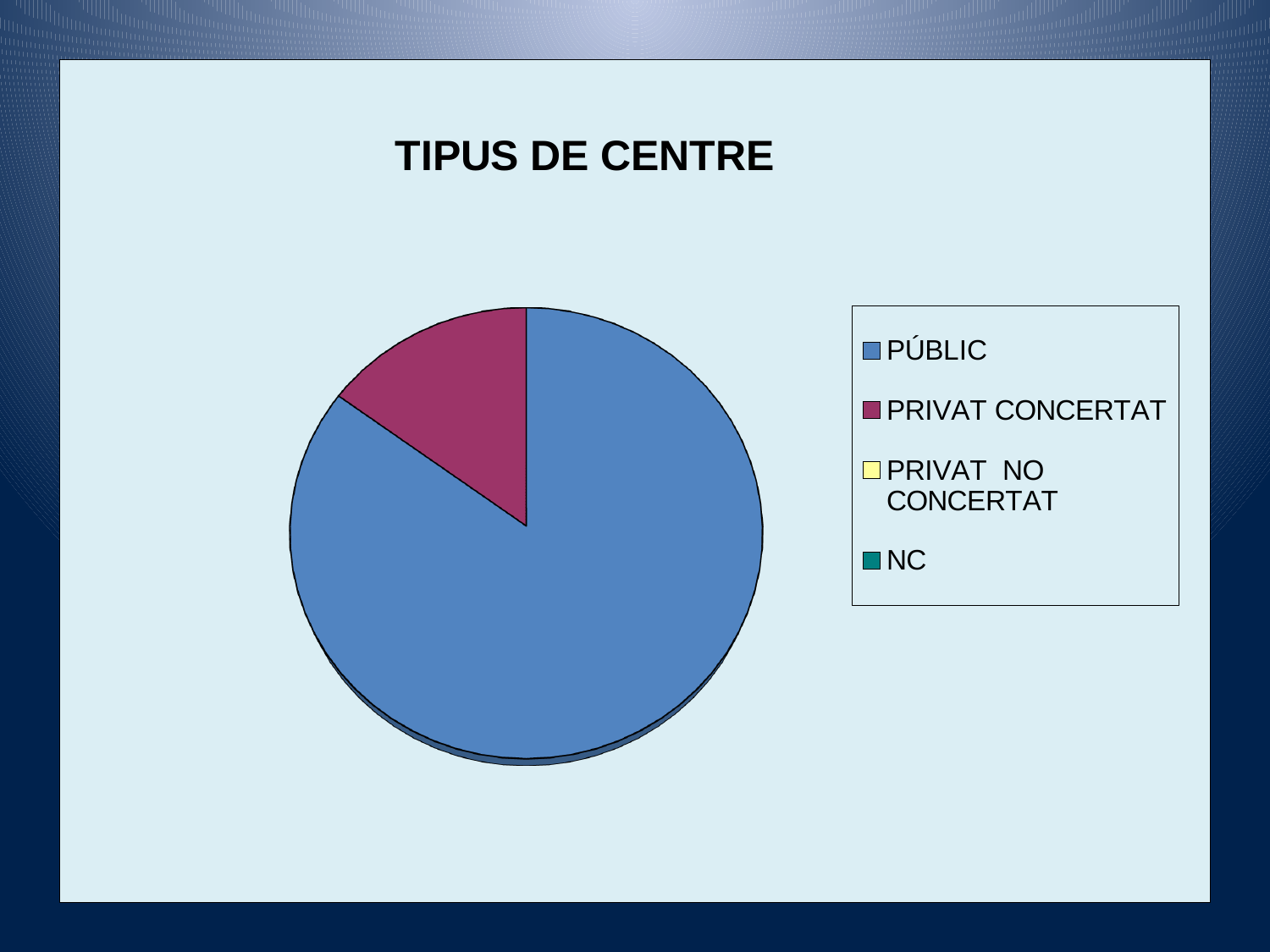
Which category has the largest slice of the pie? PÚBLIC How many slices are visibly drawn in the pie? 2 How many entries does the chart's legend list? 4 Which is larger, the slice for PÚBLIC or the slice for PRIVAT CONCERTAT? PÚBLIC Is the share of the pie for PÚBLIC greater or less than 50%? greater What colour is the slice for PRIVAT CONCERTAT? Maroon Is the share of the pie for PRIVAT CONCERTAT greater or less than 25%? less What is the title of the chart? TIPUS DE CENTRE What kind of chart is shown on the slide? Pie chart